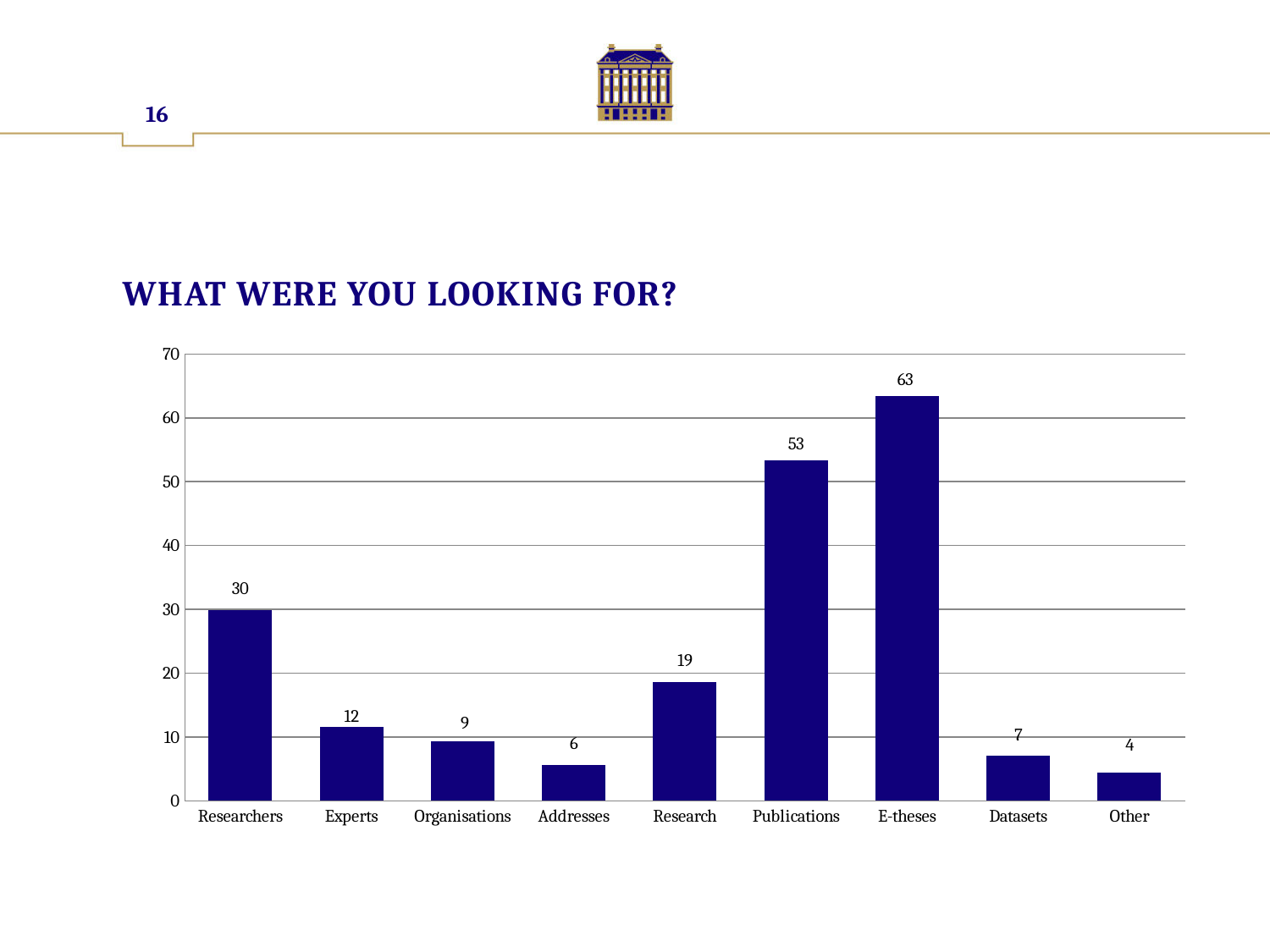
Which category has the highest value? E-theses What kind of chart is shown on the slide? bar chart What is the value for E-theses? 63 What is the difference between the values for Researchers and Research? 11 What is the value for Addresses? 6 How many categories are shown on the x axis? 9 Which category has the lowest value? Other What is the title of the chart? WHAT WERE YOU LOOKING FOR? Is the value for Publications greater or less than 50? greater Which is larger, the value for Experts or the value for Organisations? Experts What is the difference between the values for E-theses and Publications? 10 What is the value for Researchers? 30